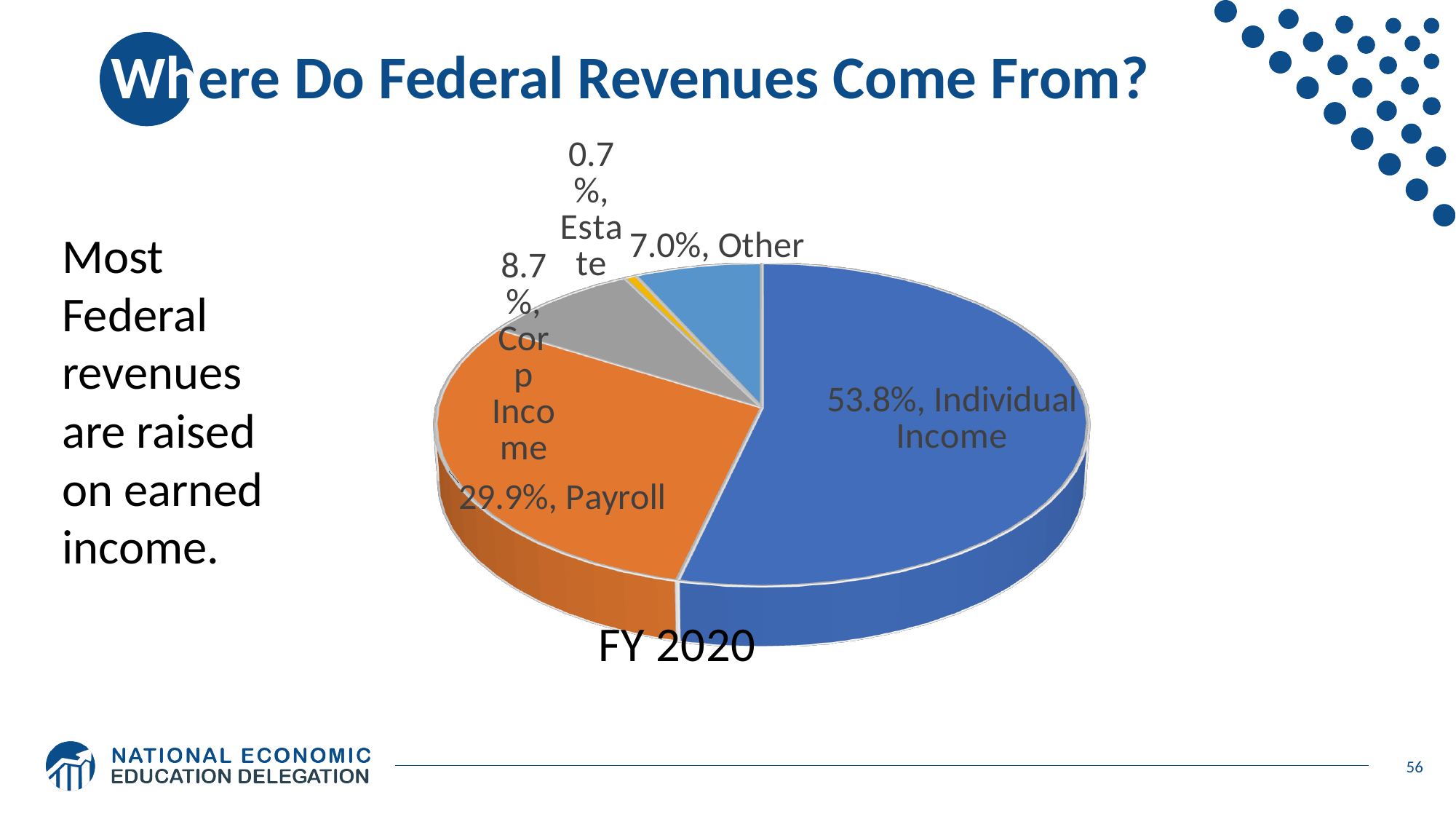
What is the difference in percentage points between the Individual Income and Payroll slices? 23.9 What share of federal revenues comes from Individual Income in the pie chart? 53.8% Which is larger, the Corp Income slice or the Other slice? Corp Income What share of federal revenues comes from Other in the pie chart? 7.0% Which slice of the pie chart is the largest? Individual Income What share of federal revenues comes from Estate in the pie chart? 0.7% How many slices does the pie chart have? 5 Which slice of the pie chart is the smallest? Estate What kind of chart is shown on the slide? pie chart What share of federal revenues comes from Payroll in the pie chart? 29.9% What share of federal revenues comes from Corp Income in the pie chart? 8.7% What fiscal year is labeled below the pie chart? FY 2020